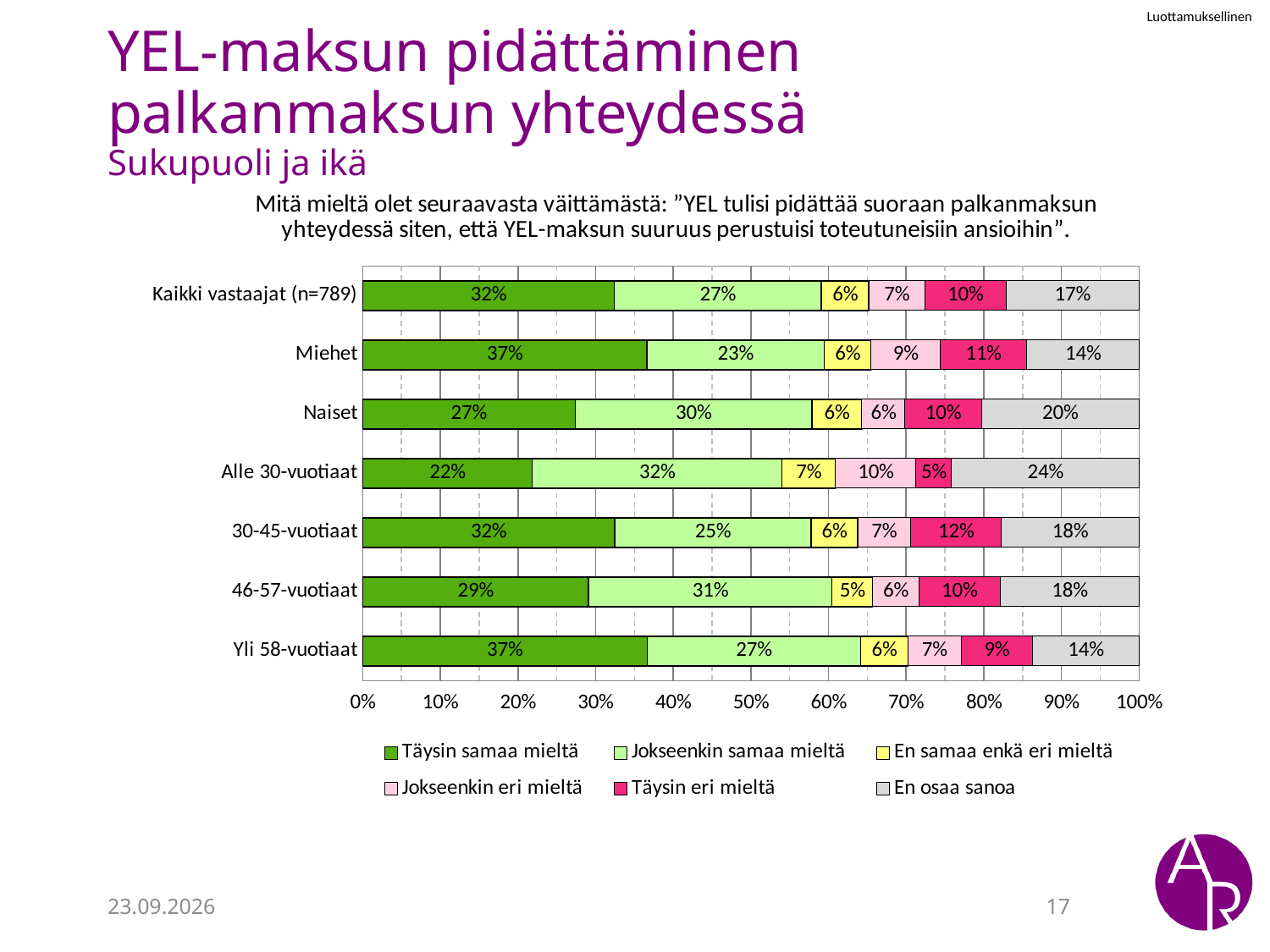
What percentage of Miehet answered "Täysin samaa mieltä"? 37% Which group has the highest "En osaa sanoa" share? Alle 30-vuotiaat What is the total of the stacked bar for Miehet? 100% What is the "En osaa sanoa" value for Naiset? 20% How many respondent groups are shown on the chart? 7 What is the "Jokseenkin samaa mieltä" value for Alle 30-vuotiaat? 32% Which is larger: the "Täysin eri mieltä" value for Miehet or for Alle 30-vuotiaat? Miehet What is the difference between the "Täysin samaa mieltä" values for Miehet and Naiset? 10 percentage points What kind of chart is shown on the slide? Stacked bar chart How many series does the legend list? 6 Which group has the lowest "Täysin samaa mieltä" share? Alle 30-vuotiaat What is the "Täysin eri mieltä" value for 30-45-vuotiaat? 12%